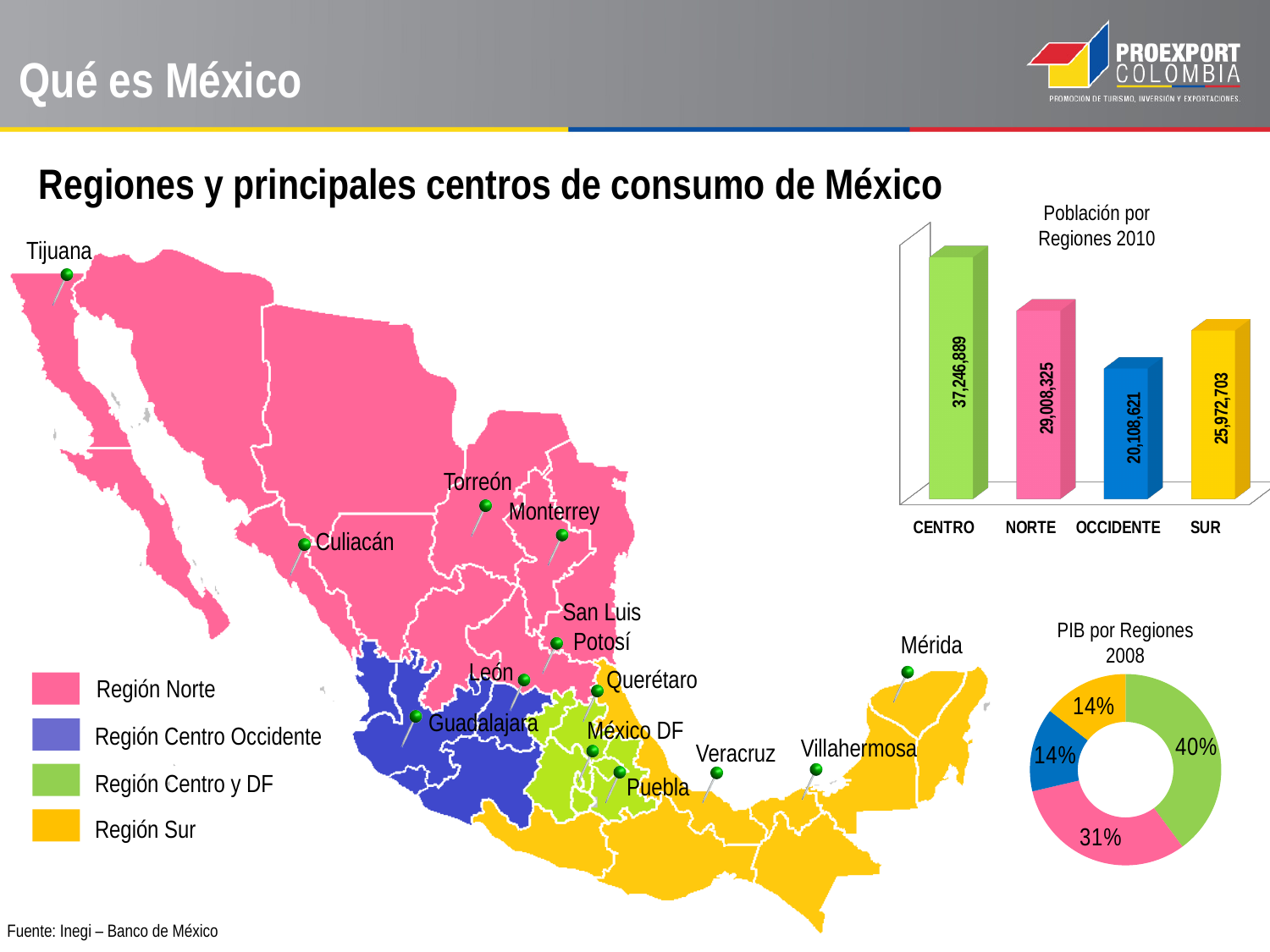
In the 'Población por Regiones 2010' bar chart, what is the population value for OCCIDENTE? 20,108,621 In the 'Población por Regiones 2010' bar chart, which has the larger population, NORTE or SUR? NORTE How many regions are shown in the 'Población por Regiones 2010' bar chart? 4 In the 'Población por Regiones 2010' bar chart, which region has the highest population? CENTRO In the 'Población por Regiones 2010' bar chart, what is the difference between the CENTRO and NORTE populations? 8,238,564 In the 'Población por Regiones 2010' bar chart, what is the population value for CENTRO? 37,246,889 In the 'Población por Regiones 2010' bar chart, what is the population value for NORTE? 29,008,325 In the 'Población por Regiones 2010' bar chart, what is the population value for SUR? 25,972,703 In the 'Población por Regiones 2010' bar chart, which region has the lowest population? OCCIDENTE In the 'PIB por Regiones 2008' chart, what share does the pink slice represent? 31% What kind of chart is 'Población por Regiones 2010'? Bar chart In the 'PIB por Regiones 2008' chart, what is the largest share shown? 40%